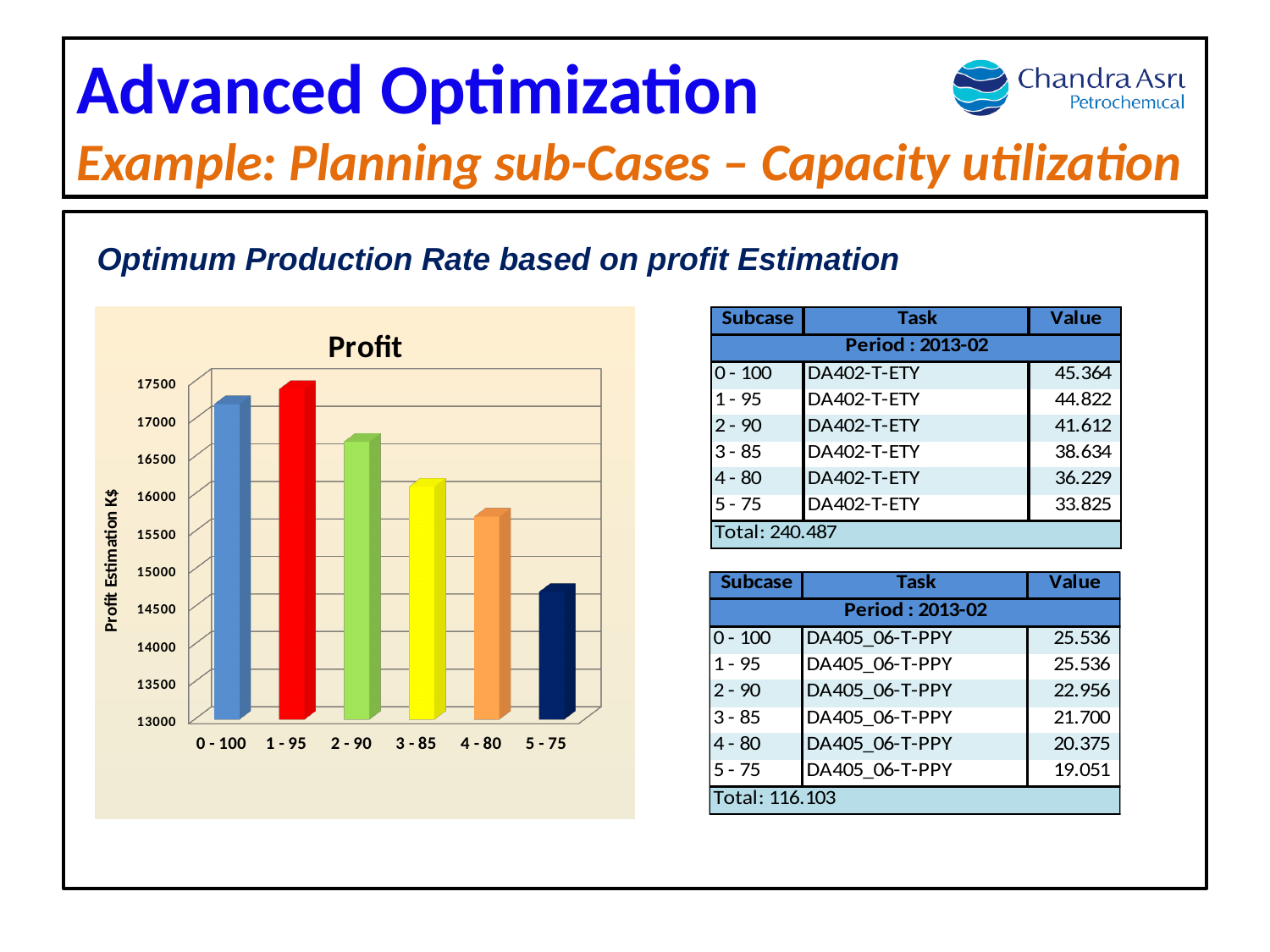
How many categories are plotted on the chart? 6 Is the value for 2 - 90 greater or less than 17000? less What is the title of the chart? Profit What is the label of the vertical axis of the chart? Profit Estimation K$ Is the value for 1 - 95 greater or less than 17000? greater Which category has the highest profit estimation? 1 - 95 Is the value for 5 - 75 greater or less than 15000? less Which is larger, the value for 0 - 100 or the value for 2 - 90? 0 - 100 From 1 - 95 to 5 - 75, do the values rise or fall along the x axis? fall What kind of chart is shown on the slide? bar chart Which category has the lowest profit estimation? 5 - 75